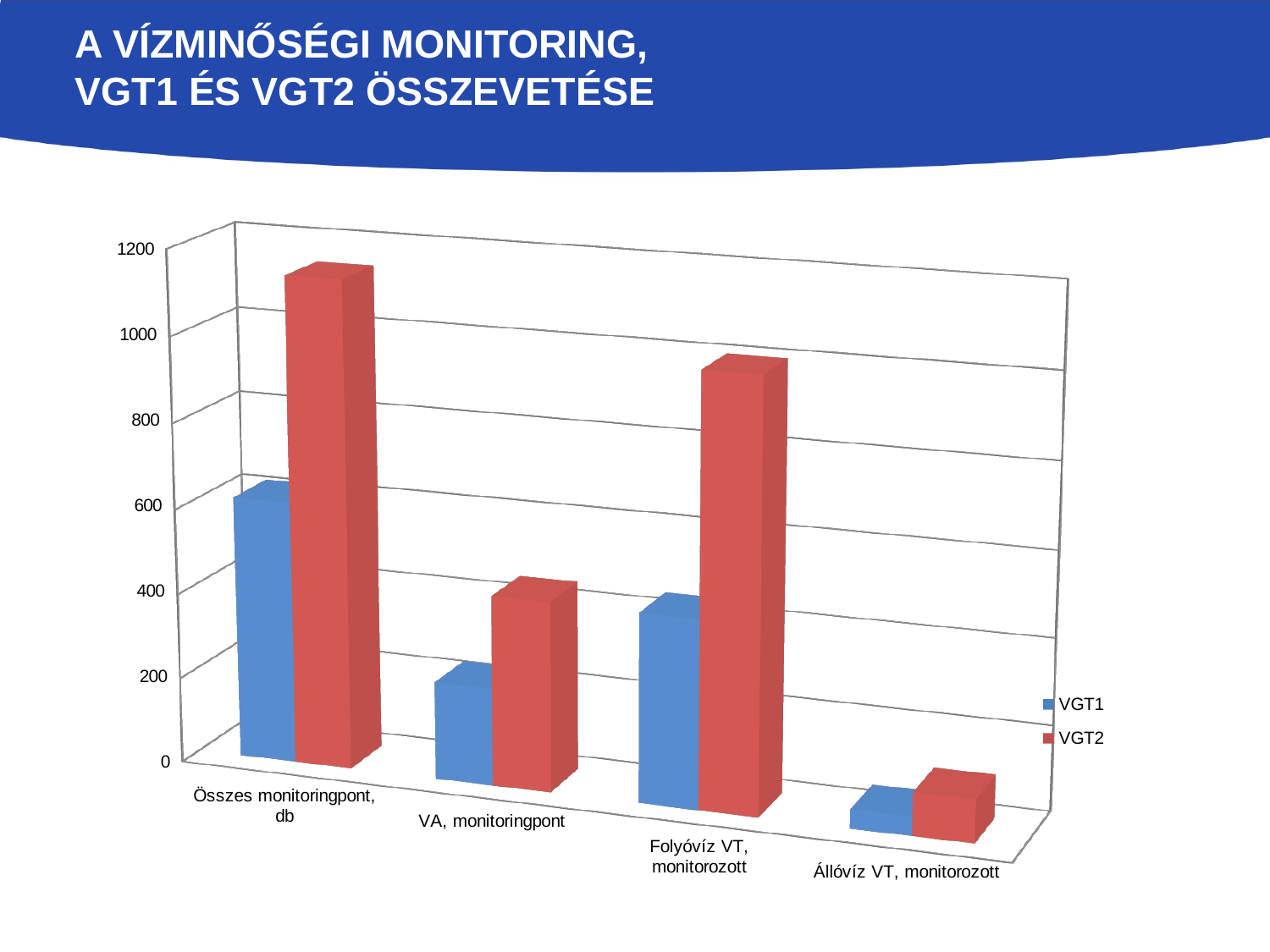
Is the VGT1 value for Összes monitoringpont, db greater or less than 400? greater Is the VGT2 value for Összes monitoringpont, db greater or less than 1000? greater Which category has the lowest VGT1 value? Állóvíz VT, monitorozott For Folyóvíz VT, monitorozott, which series has the larger value, VGT1 or VGT2? VGT2 What kind of chart is shown on the slide? bar chart Which category has the highest VGT2 value? Összes monitoringpont, db Is the VGT2 value for Folyóvíz VT, monitorozott greater or less than 800? greater Which colour represents the VGT2 series in the legend? red How many categories are shown on the x axis? 4 How many series does the legend list? 2